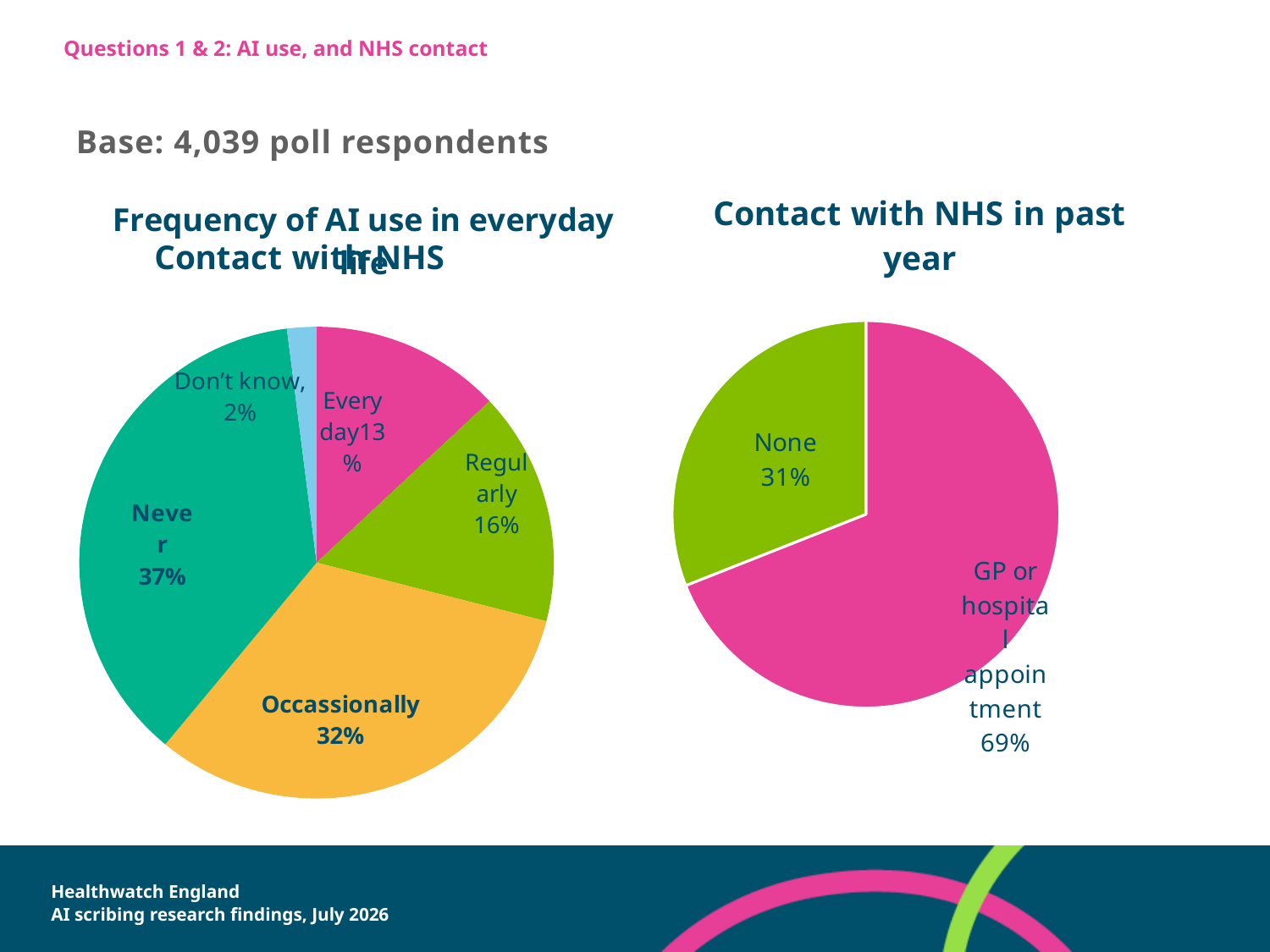
What type of chart is used for Contact with NHS in past year? Pie chart In the left pie chart (Frequency of AI use in everyday life), what percentage use AI every day? 13% In the left pie chart (Frequency of AI use in everyday life), which is larger: Regularly or Every day? Regularly In the right pie chart (Contact with NHS in past year), what percentage had no contact (None)? 31% In the left pie chart (Frequency of AI use in everyday life), how many slices are there? 5 In the left pie chart (Frequency of AI use in everyday life), what percentage use AI occasionally? 32% In the right pie chart (Contact with NHS in past year), what percentage had a GP or hospital appointment? 69% In the left pie chart (Frequency of AI use in everyday life), what is the difference in percentage points between Never and Occasionally? 5 percentage points In the right pie chart (Contact with NHS in past year), what is the difference in percentage points between GP or hospital appointment and None? 38 percentage points In the left pie chart (Frequency of AI use in everyday life), what share of respondents said they never use AI? 37% In the left pie chart (Frequency of AI use in everyday life), which category has the smallest share? Don't know In the left pie chart (Frequency of AI use in everyday life), which category has the largest share? Never